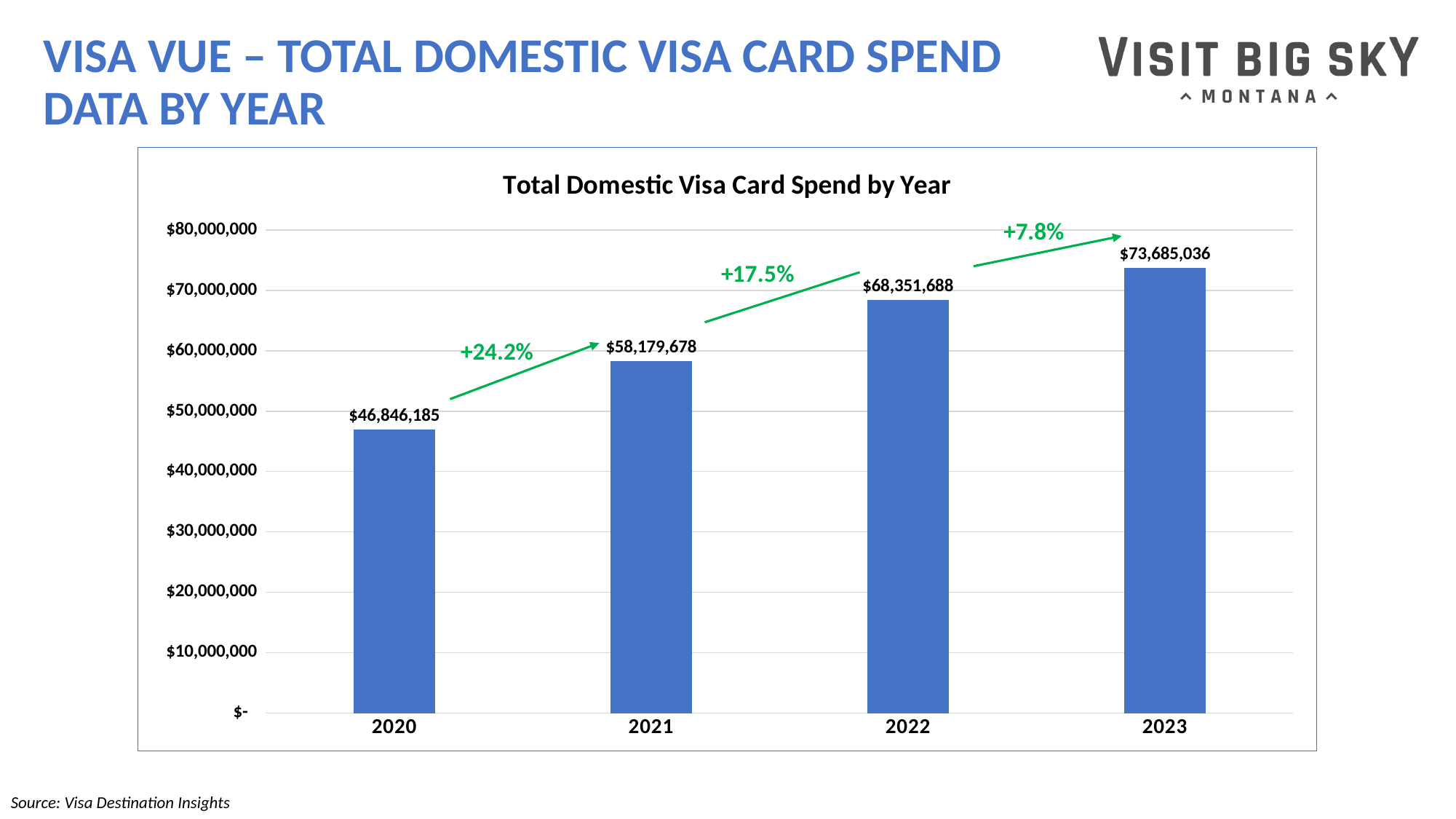
What is the total domestic Visa card spend for 2022? $68,351,688 What is the total domestic Visa card spend for 2020? $46,846,185 Which year has the lowest total domestic Visa card spend? 2020 What is the difference in spend between 2023 and 2020? $26,838,851 What percentage growth is shown between 2021 and 2022? +17.5% How many years are shown in the chart? 4 Is the spend for 2021 greater or less than $60,000,000? less What is the difference in spend between 2022 and 2021? $10,172,010 Which year has the highest total domestic Visa card spend? 2023 What kind of chart is shown on the slide? Bar chart Which year had higher spend, 2021 or 2022? 2022 What is the total domestic Visa card spend for 2023? $73,685,036